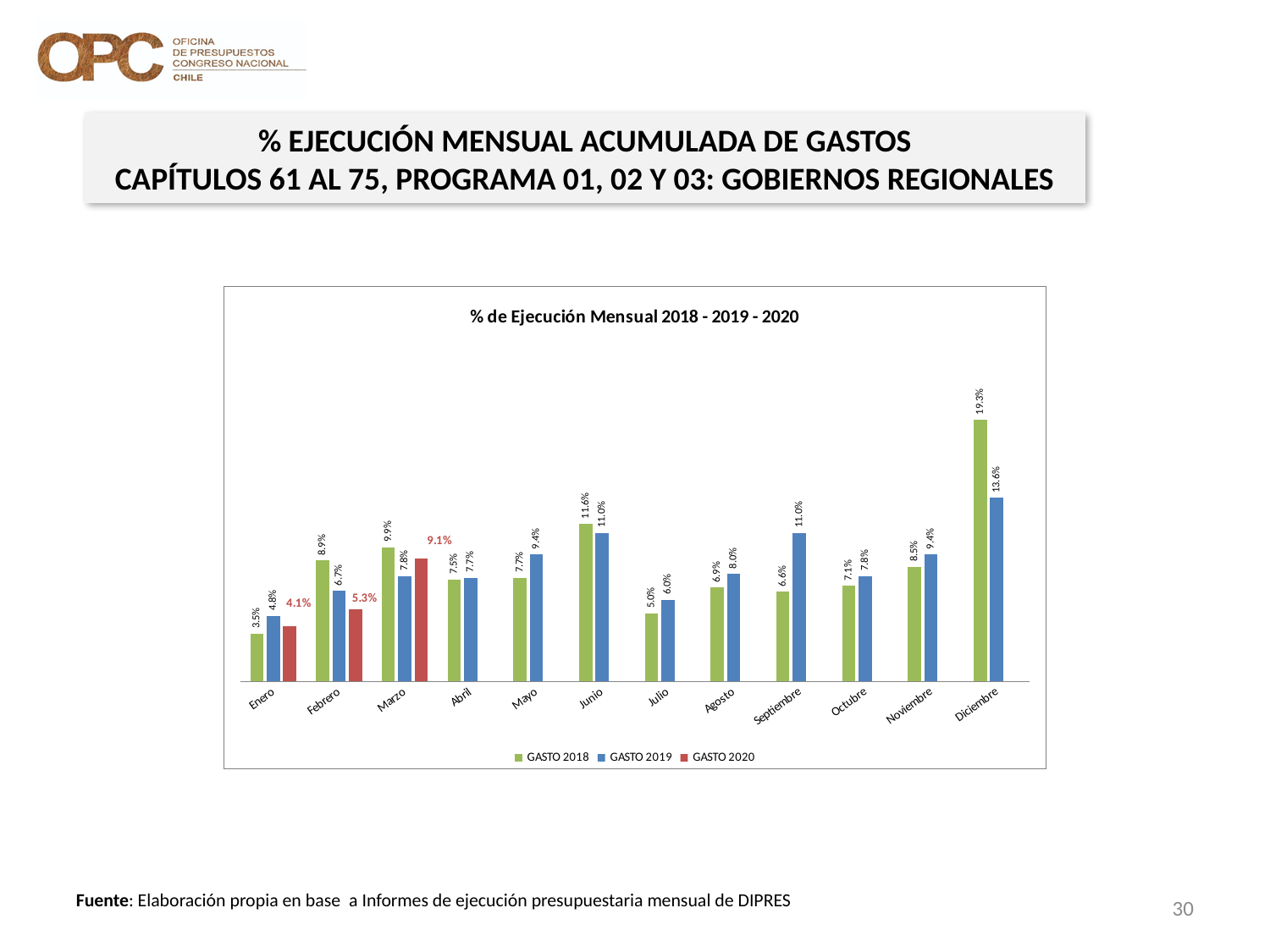
Which month has the highest value for GASTO 2019? Diciembre What is the value for GASTO 2018 in Diciembre? 19.3% What is the value for GASTO 2020 in Marzo? 9.1% For how many months is a GASTO 2020 value plotted? 3 Which month has the lowest value for GASTO 2018? Enero Which is larger in Febrero, GASTO 2018 or GASTO 2020? GASTO 2018 What is the value for GASTO 2019 in Septiembre? 11.0% What is the difference between GASTO 2018 and GASTO 2019 in Diciembre? 5.7% What is the value for GASTO 2018 in Enero? 3.5% How many series does the legend list? 3 How many months are shown on the x axis? 12 What kind of chart is shown? Bar chart